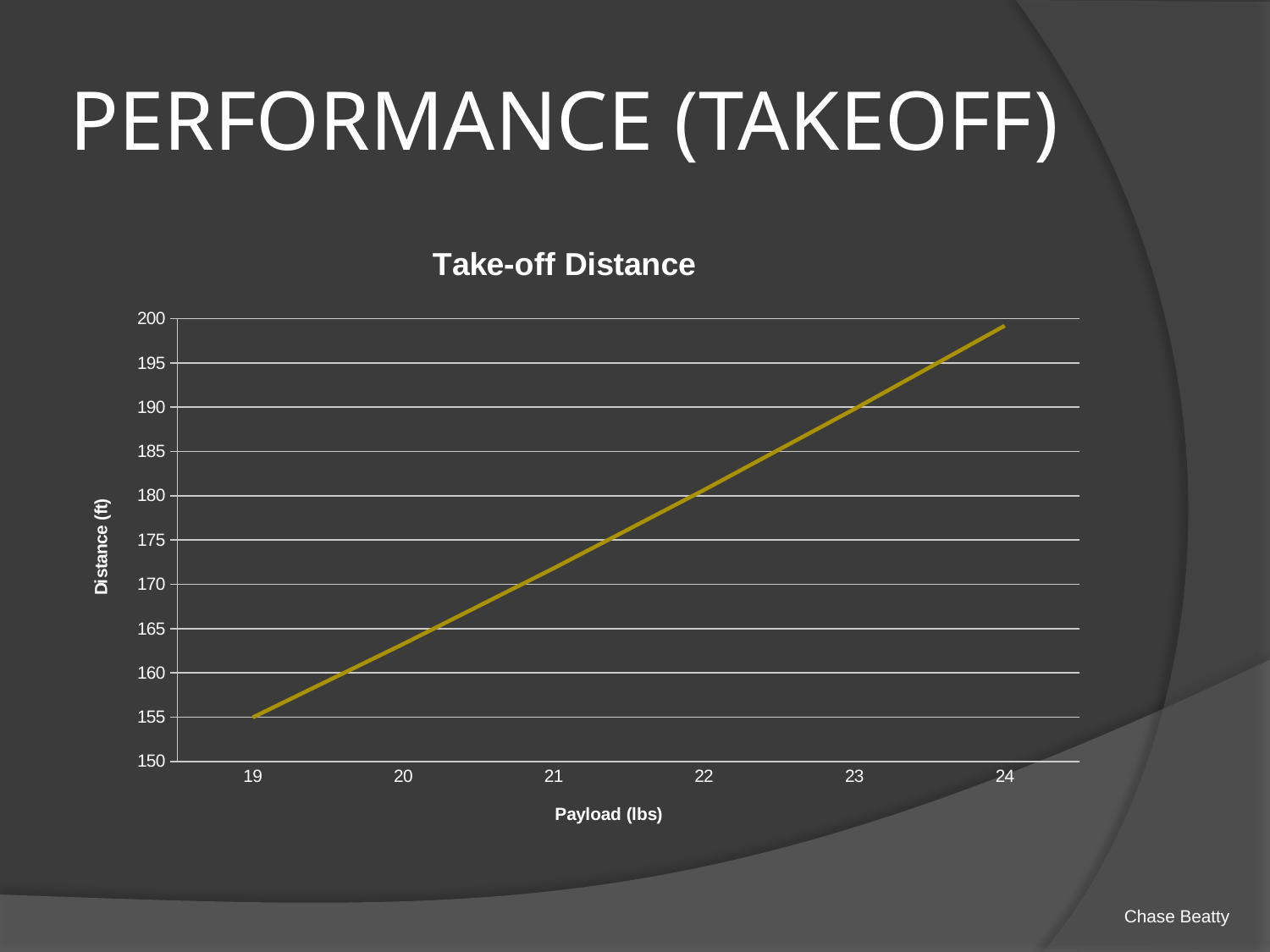
What is the title of the chart? Take-off Distance Is the take-off distance at a payload of 20 lbs greater or less than 170? less At which payload is the take-off distance lowest? 19 Is the take-off distance at a payload of 22 lbs greater or less than 175? greater Does the take-off distance rise or fall as payload increases from 19 to 24 lbs? rise At which payload is the take-off distance highest? 24 What kind of chart is shown on the slide? line chart Is the take-off distance at a payload of 24 lbs greater or less than 195? greater How many payload values are marked on the x axis? 6 Which payload has the larger take-off distance, 21 lbs or 23 lbs? 23 lbs What is the label of the x axis? Payload (lbs)